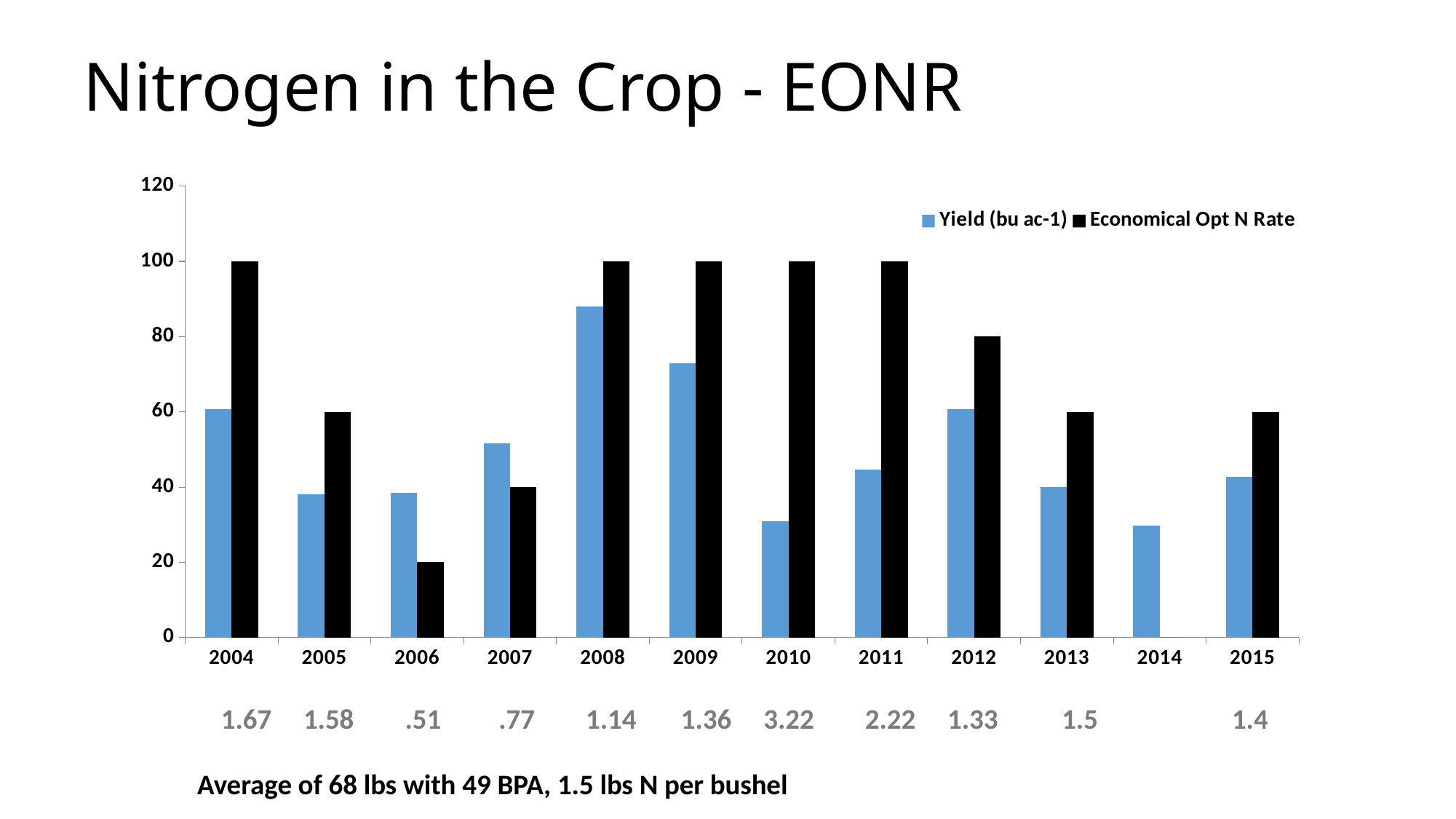
How many series does the legend list? 2 Is the Yield (bu ac-1) for 2008 greater or less than 80? greater What is the Economical Opt N Rate for 2006? 20 Which year has the highest Yield (bu ac-1)? 2008 What is the difference between the Economical Opt N Rate for 2004 and for 2012? 20 How many years are shown along the x axis? 12 Which year has the larger Yield (bu ac-1), 2004 or 2005? 2004 What kind of chart is shown on the slide? Bar chart What is the Economical Opt N Rate for 2012? 80 What colour are the bars for the Yield (bu ac-1) series? Blue Is the Yield (bu ac-1) for 2010 greater or less than 40? less What is the Economical Opt N Rate for 2015? 60